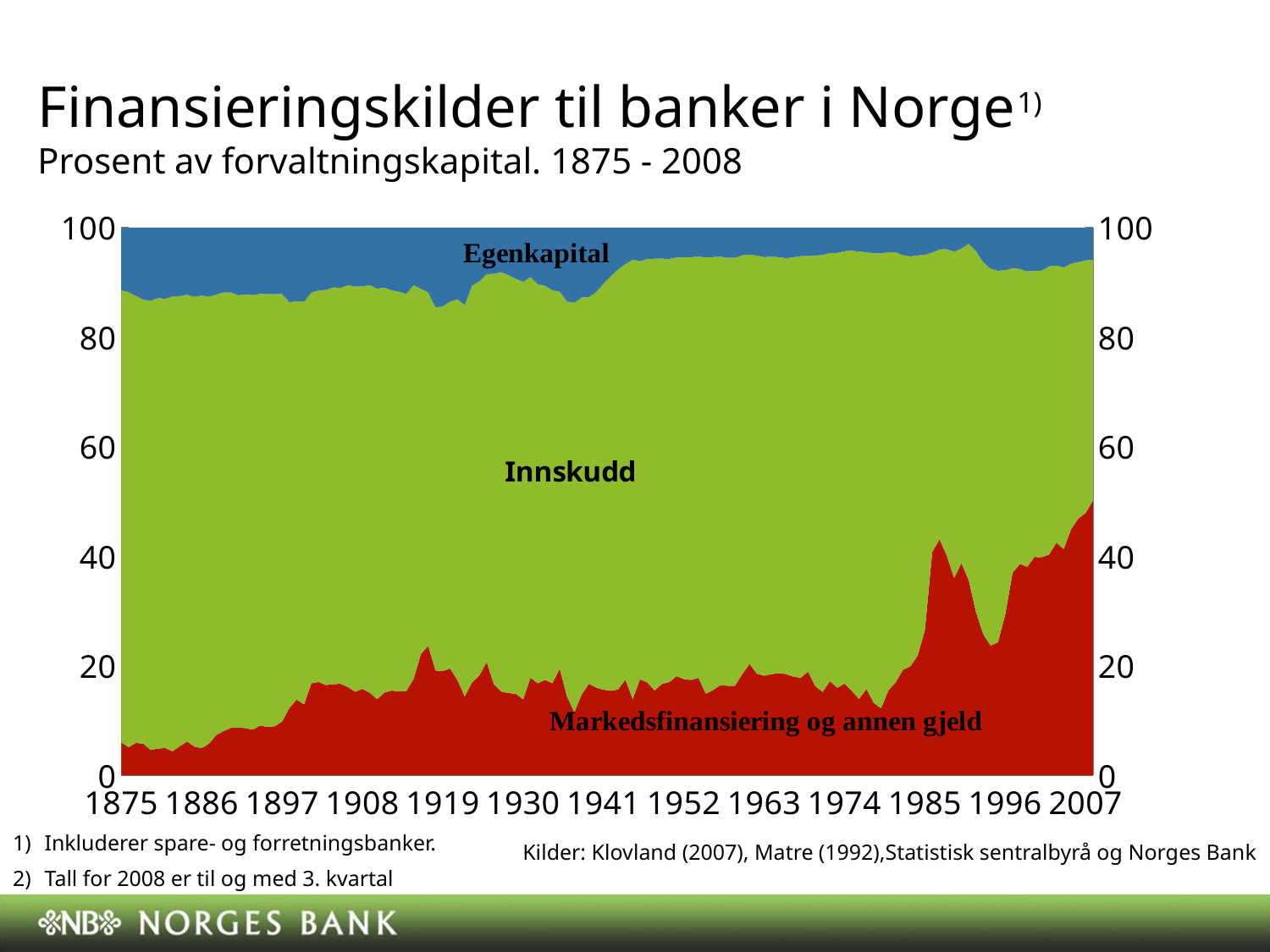
Which series has the smallest share in 2007: Egenkapital or Innskudd? Egenkapital What is the title of the chart? Finansieringskilder til banker i Norge How many series (areas) are labelled in the chart? 3 Which colour represents Innskudd in the chart? Green Is the value for Markedsfinansiering og annen gjeld around 1985 greater or less than 20? greater Which series occupies the largest share of forvaltningskapital across the whole period? Innskudd How many year labels are shown on the x axis? 13 Is the value for Markedsfinansiering og annen gjeld at the end of the series (2007/2008) greater or less than 40? greater Is the value for Markedsfinansiering og annen gjeld in 1875 greater or less than 20? less Does the share of Markedsfinansiering og annen gjeld rise or fall from 1875 to 2008? Rise Does the share of Egenkapital rise or fall from 1875 to 2008? Fall What kind of chart is shown on the slide? Stacked area chart